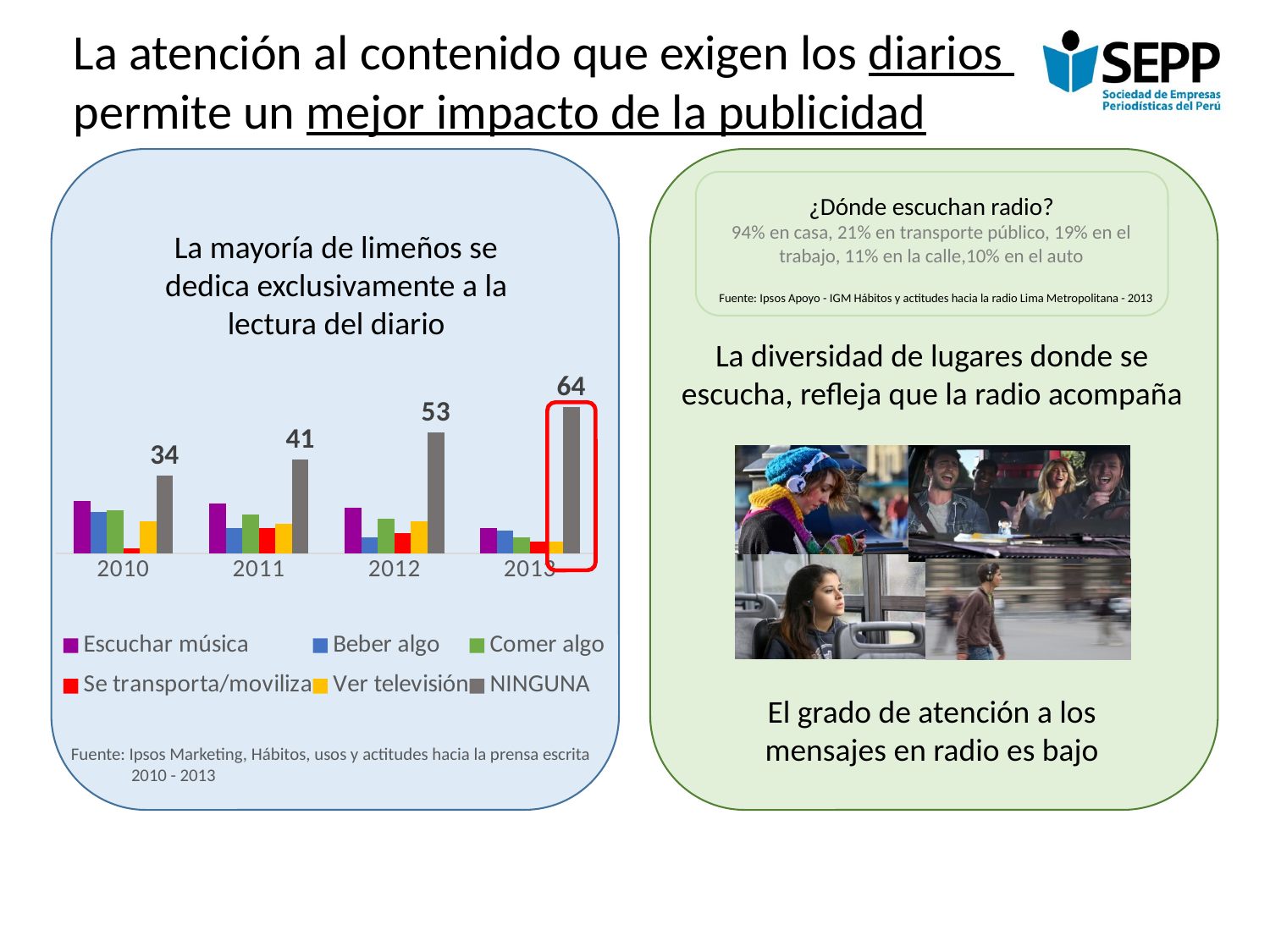
In which year is the NINGUNA value highest? 2013 What is the difference between the NINGUNA values for 2013 and 2010? 30 What is the difference between the NINGUNA values for 2012 and 2011? 12 How many years are shown on the x axis of the chart? 4 What kind of chart is shown on the slide? Bar chart Which is larger, the NINGUNA value for 2011 or for 2012? 2012 What is the value for NINGUNA in 2012? 53 What is the value for NINGUNA in 2010? 34 Does the NINGUNA value rise or fall from 2010 to 2013? Rise What is the value for NINGUNA in 2013? 64 How many series does the chart legend list? 6 In which year is the NINGUNA value lowest? 2010